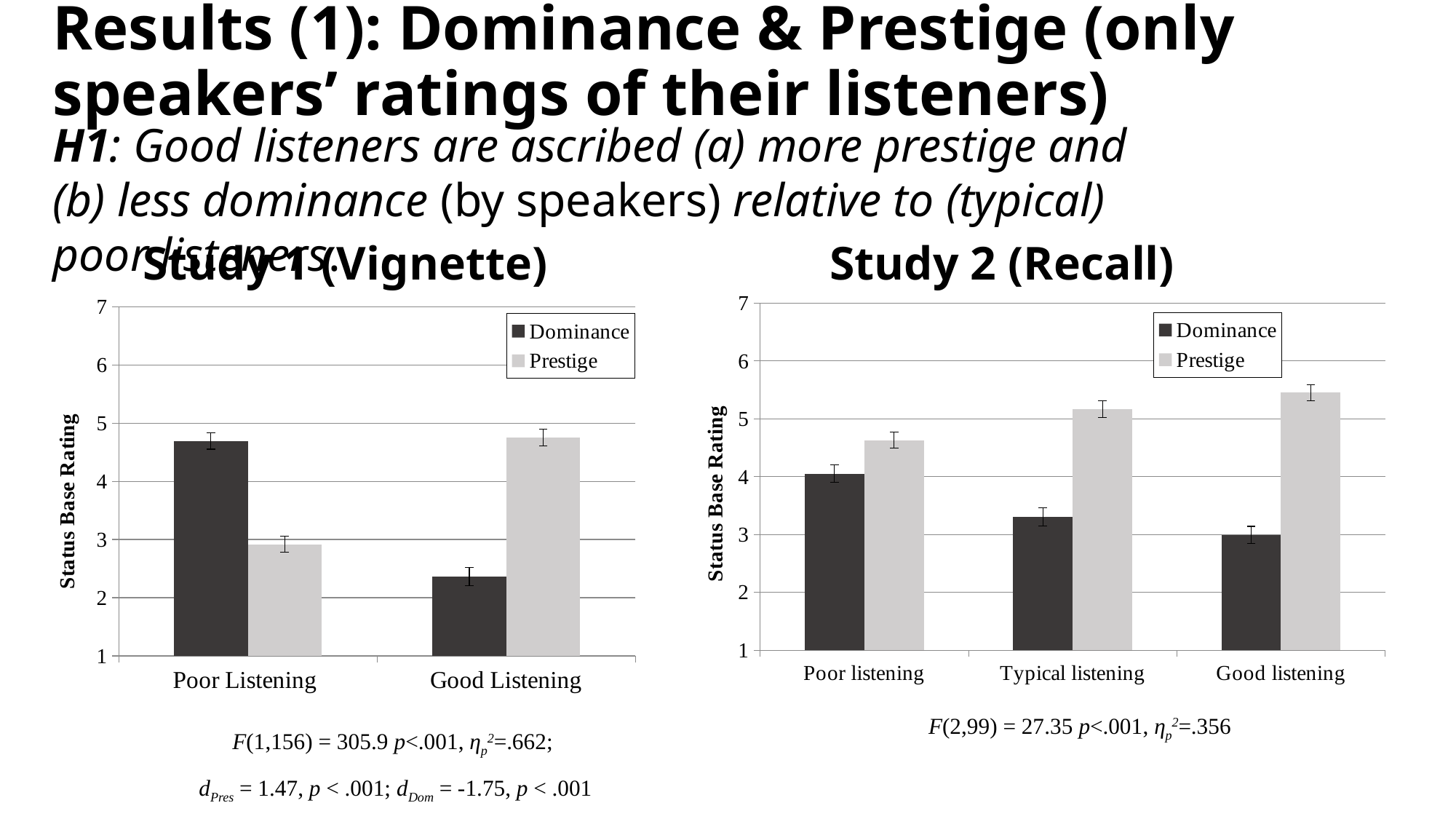
In the Study 1 (Vignette) chart, how many series does the legend list? 2 In the Study 2 (Recall) chart, is the Prestige value for Good listening greater or less than 5? greater In the Study 2 (Recall) chart, is the Dominance value for Typical listening greater or less than 4? less In the Study 1 (Vignette) chart, is the Dominance value for Good Listening greater or less than 3? less In the Study 1 (Vignette) chart, which is larger for Poor Listening, Dominance or Prestige? Dominance In the Study 1 (Vignette) chart, what kind of chart is shown? bar chart In the Study 1 (Vignette) chart, which is larger for Good Listening, Dominance or Prestige? Prestige In the Study 2 (Recall) chart, do the Dominance values rise or fall from Poor listening to Good listening? fall In the Study 2 (Recall) chart, what is the label on the y axis? Status Base Rating In the Study 2 (Recall) chart, how many listening categories are shown on the x axis? 3 In the Study 1 (Vignette) chart, how many listening categories are shown on the x axis? 2